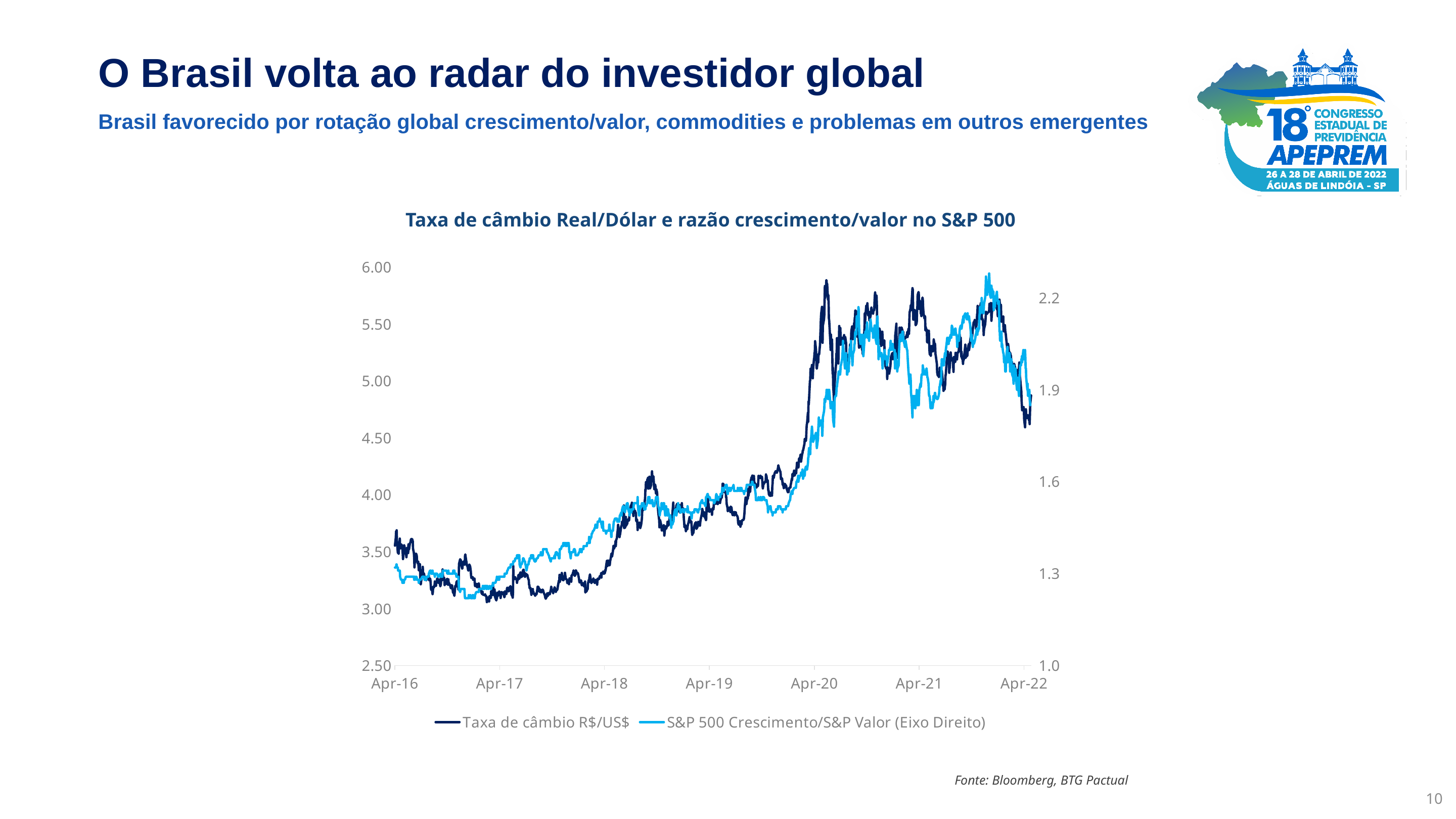
How many date labels are shown on the x axis? 7 What is the title of the chart? Taxa de câmbio Real/Dólar e razão crescimento/valor no S&P 500 What kind of chart is shown on the slide? line chart Is the S&P 500 Crescimento/S&P Valor value at Apr-16 greater or less than 1.6? less Does the Taxa de câmbio R$/US$ series rise or fall between Apr-16 and Apr-20? rise Is the Taxa de câmbio R$/US$ value at Apr-20 greater or less than 4.50? greater Is the Taxa de câmbio R$/US$ value at Apr-16 greater or less than 4.00? less How many series does the legend list? 2 Which series is plotted on the right-hand axis? S&P 500 Crescimento/S&P Valor Is the Taxa de câmbio R$/US$ value higher at Apr-20 or at Apr-16? Apr-20 Does the Taxa de câmbio R$/US$ series rise or fall between Apr-21 and Apr-22? fall